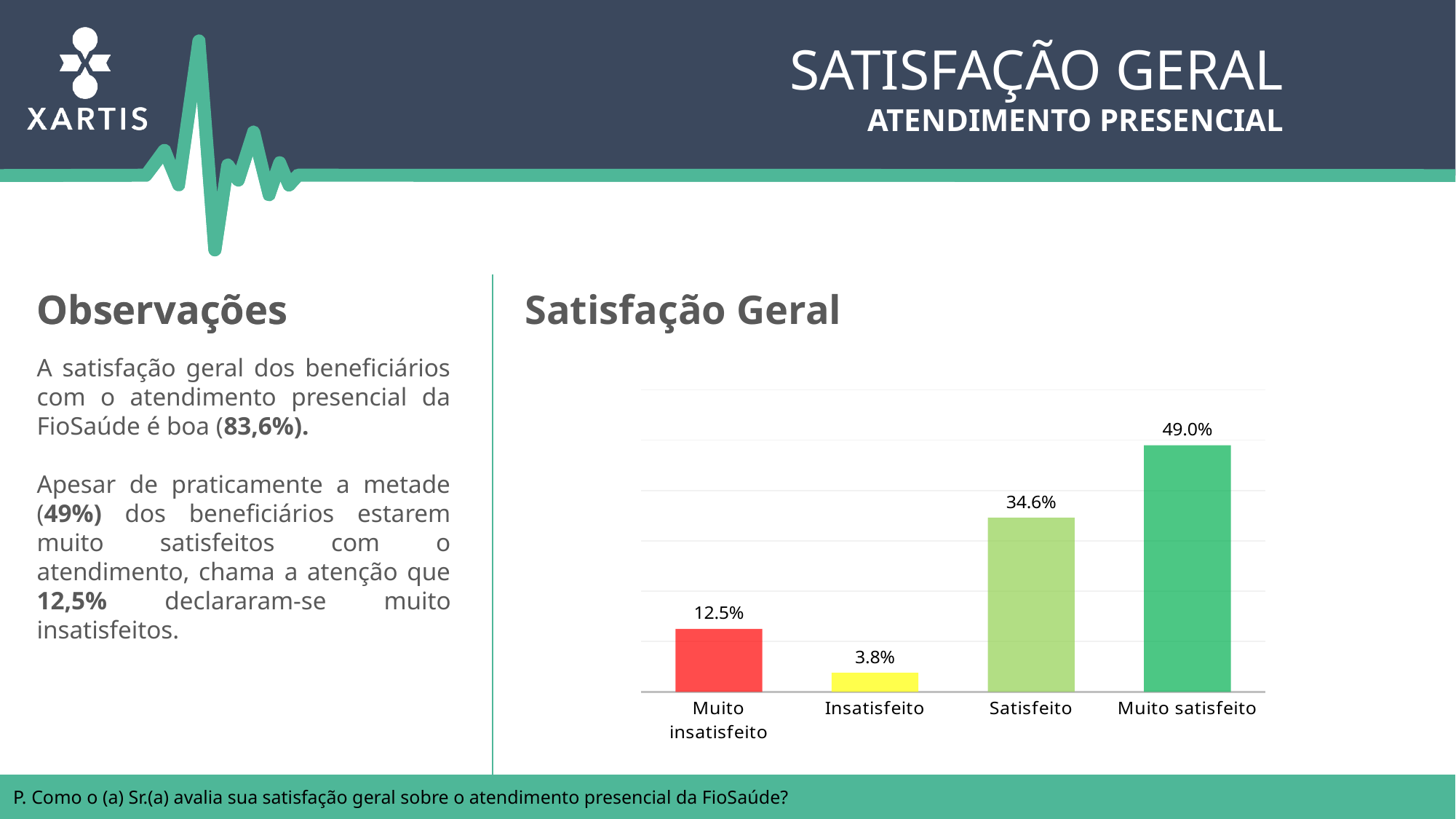
What is the value for Muito satisfeito? 49.0% What is the value for Insatisfeito? 3.8% What is the value for Muito insatisfeito? 12.5% What is the title of the chart? Satisfação Geral What is the value for Satisfeito? 34.6% What is the difference between the values for Muito insatisfeito and Insatisfeito? 8.7% Which category has the highest value? Muito satisfeito Which is larger, the value for Muito insatisfeito or the value for Insatisfeito? Muito insatisfeito What is the difference between the values for Muito satisfeito and Satisfeito? 14.4% How many categories are shown in the chart? 4 Which category has the lowest value? Insatisfeito What kind of chart is shown on the slide? Bar chart